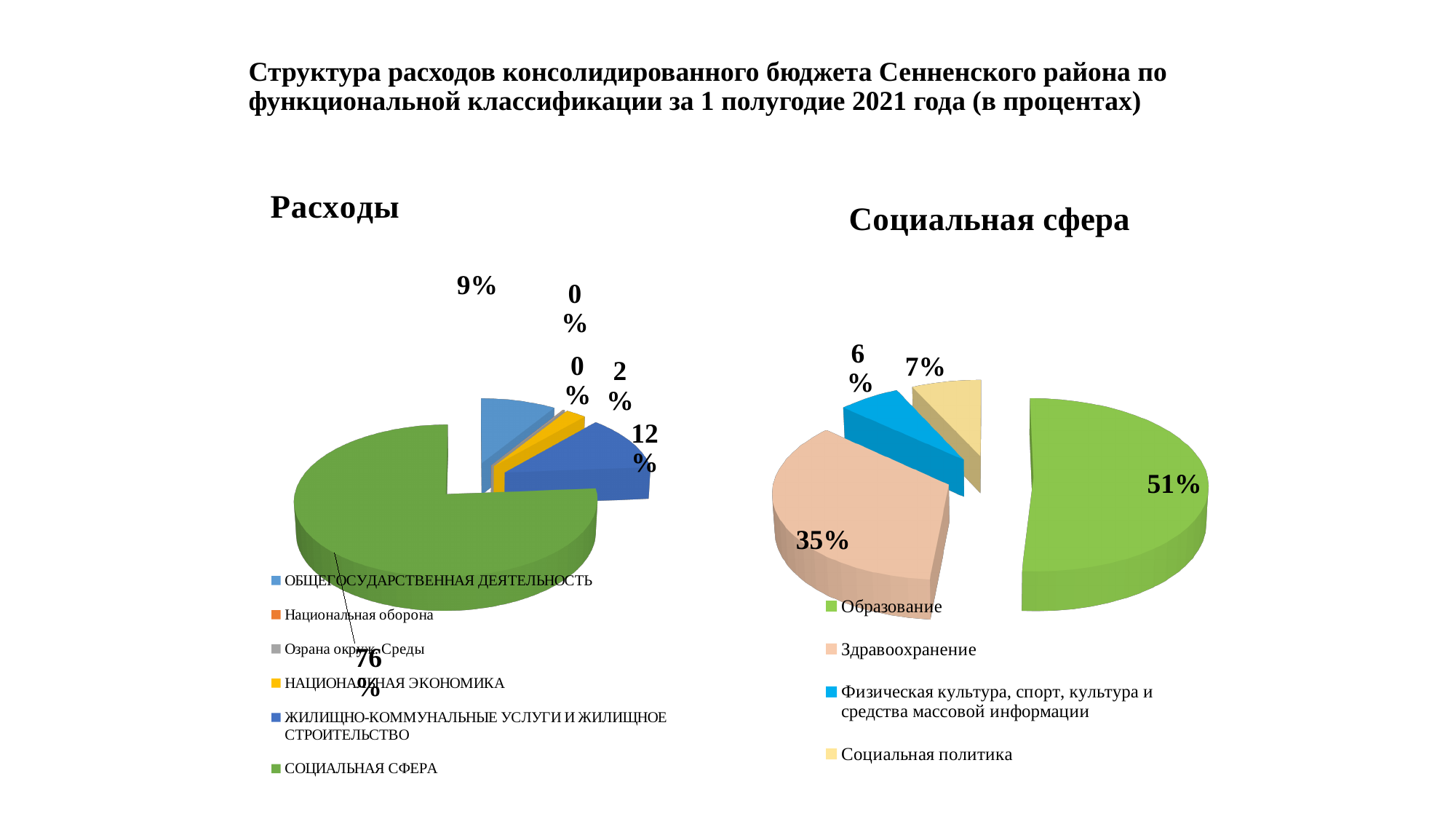
In the 'Расходы' chart, which category has the largest share? СОЦИАЛЬНАЯ СФЕРА In the 'Социальная сфера' chart, which category has the smallest share? Физическая культура, спорт, культура и средства массовой информации In the 'Расходы' chart, what share does НАЦИОНАЛЬНАЯ ЭКОНОМИКА have? 2% In the 'Расходы' chart, what share does СОЦИАЛЬНАЯ СФЕРА have? 76% In the 'Расходы' chart, what share does ЖИЛИЩНО-КОММУНАЛЬНЫЕ УСЛУГИ И ЖИЛИЩНОЕ СТРОИТЕЛЬСТВО have? 12% What type of chart is the 'Социальная сфера' chart? Pie chart In the 'Расходы' chart, what share does ОБЩЕГОСУДАРСТВЕННАЯ ДЕЯТЕЛЬНОСТЬ have? 9% In the 'Социальная сфера' chart, what share does Социальная политика have? 7% In the 'Социальная сфера' chart, what share does Здравоохранение have? 35% In the 'Расходы' chart, how many categories does the legend list? 6 In the 'Социальная сфера' chart, what is the difference between the shares of Образование and Здравоохранение? 16% In the 'Социальная сфера' chart, what share does Образование have? 51%